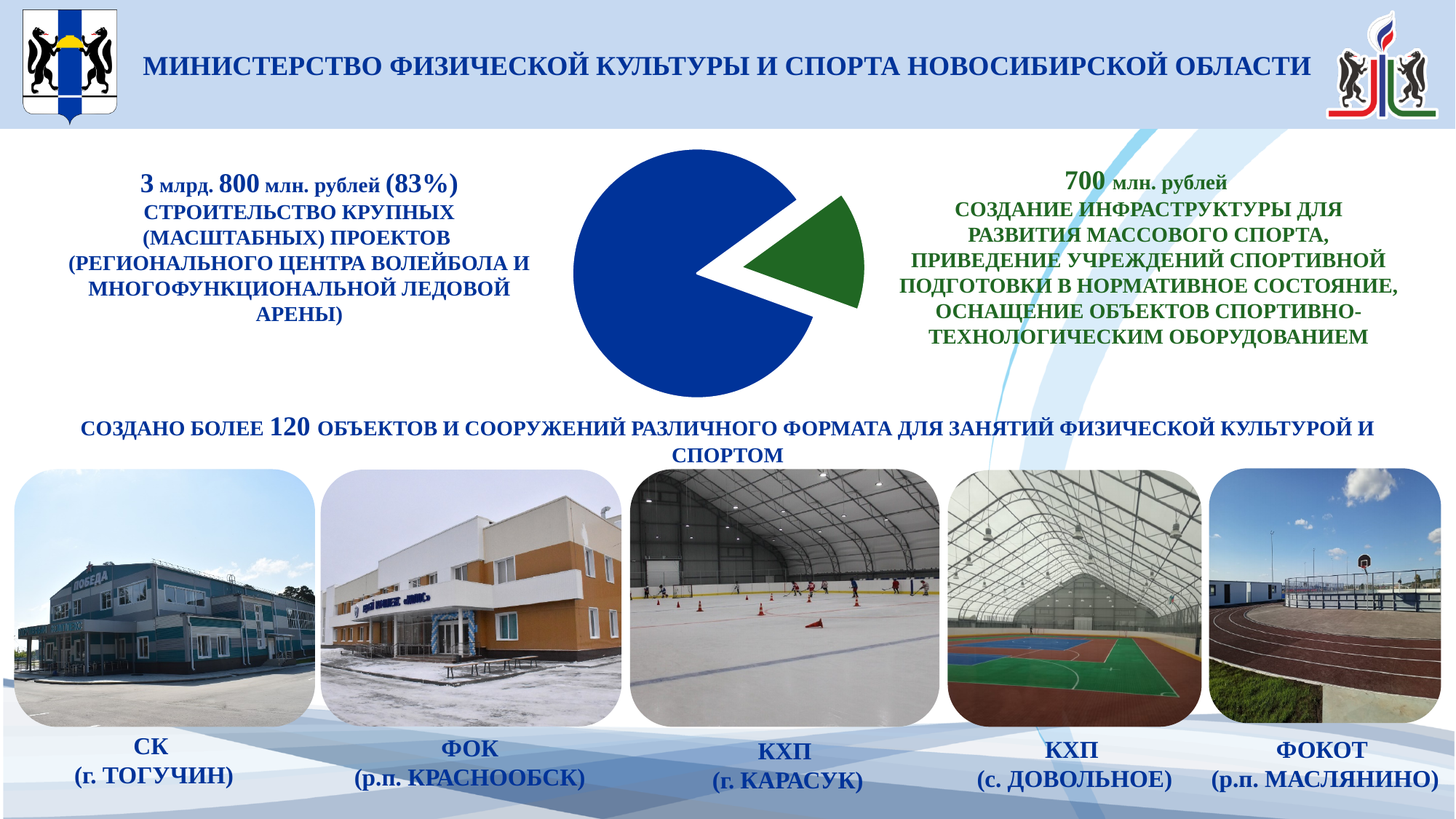
Which category in the pie chart has the smallest amount? Создание инфраструктуры для развития массового спорта (700 млн. рублей) Which category in the pie chart has the largest amount? Строительство крупных (масштабных) проектов (3 млрд. 800 млн. рублей) What amount is given for the green slice of the pie chart (creation of infrastructure for mass sport)? 700 млн. рублей What percentage share is printed for the blue slice of the pie chart (construction of large-scale projects)? 83% What amount is given for the blue slice of the pie chart (construction of large-scale projects)? 3 млрд. 800 млн. рублей What colour is the slice representing the creation of infrastructure for mass sport in the pie chart? green Is the share of the blue slice in the pie chart greater or less than 50%? greater How many slices does the pie chart have? 2 What kind of chart is shown on the slide? pie chart What colour is the slice representing the construction of large-scale projects in the pie chart? blue By how much does the amount for the blue slice exceed the amount for the green slice in the pie chart? 3 млрд. 100 млн. рублей Which slice of the pie chart is larger, the blue one or the green one? the blue one